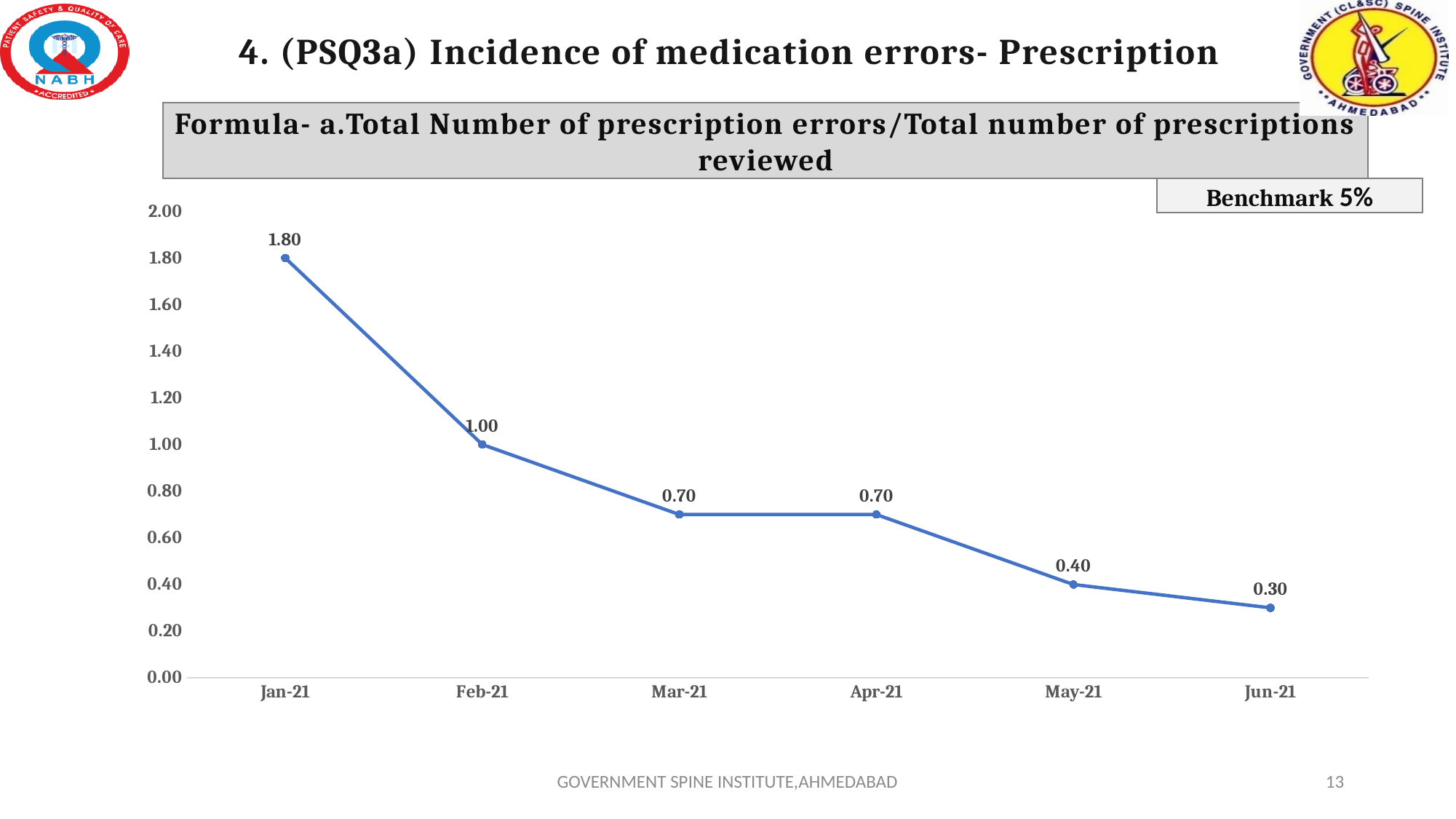
How many months are plotted on the chart? 6 What kind of chart is shown on the slide? Line chart What is the value for Jun-21? 0.30 Which month has the lowest value? Jun-21 Which month has the highest value? Jan-21 Do the values rise or fall from Jan-21 to Jun-21? Fall What is the difference between the values for Jan-21 and Feb-21? 0.80 What is the value for Jan-21? 1.80 What is the value for May-21? 0.40 What is the value for Feb-21? 1.00 What is the difference between the values for Apr-21 and Jun-21? 0.40 Which is larger, the value for Feb-21 or the value for May-21? Feb-21